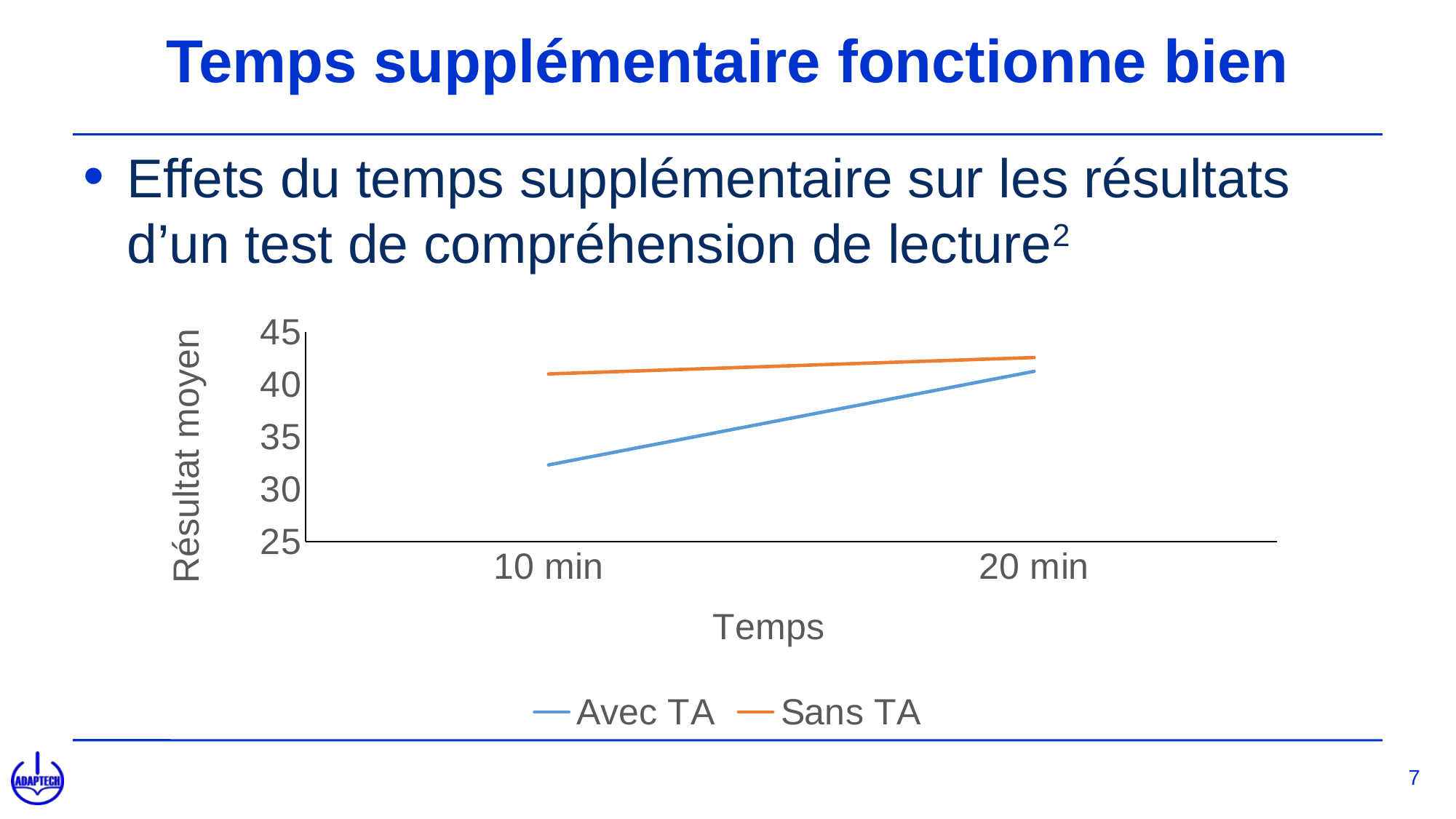
Is the value for Avec TA at 10 min greater or less than 35? less Does the Avec TA line rise or fall from 10 min to 20 min? rise At 10 min, which series has the higher value, Avec TA or Sans TA? Sans TA What is the title of the y axis? Résultat moyen Is the value for Sans TA at 10 min greater or less than 40? greater Which series is drawn in orange? Sans TA Is the value for Avec TA at 20 min greater or less than 40? greater How many series does the legend list? 2 How many time points are shown on the x axis? 2 Does the Sans TA line rise or fall from 10 min to 20 min? rise What kind of chart is shown on the slide? line chart